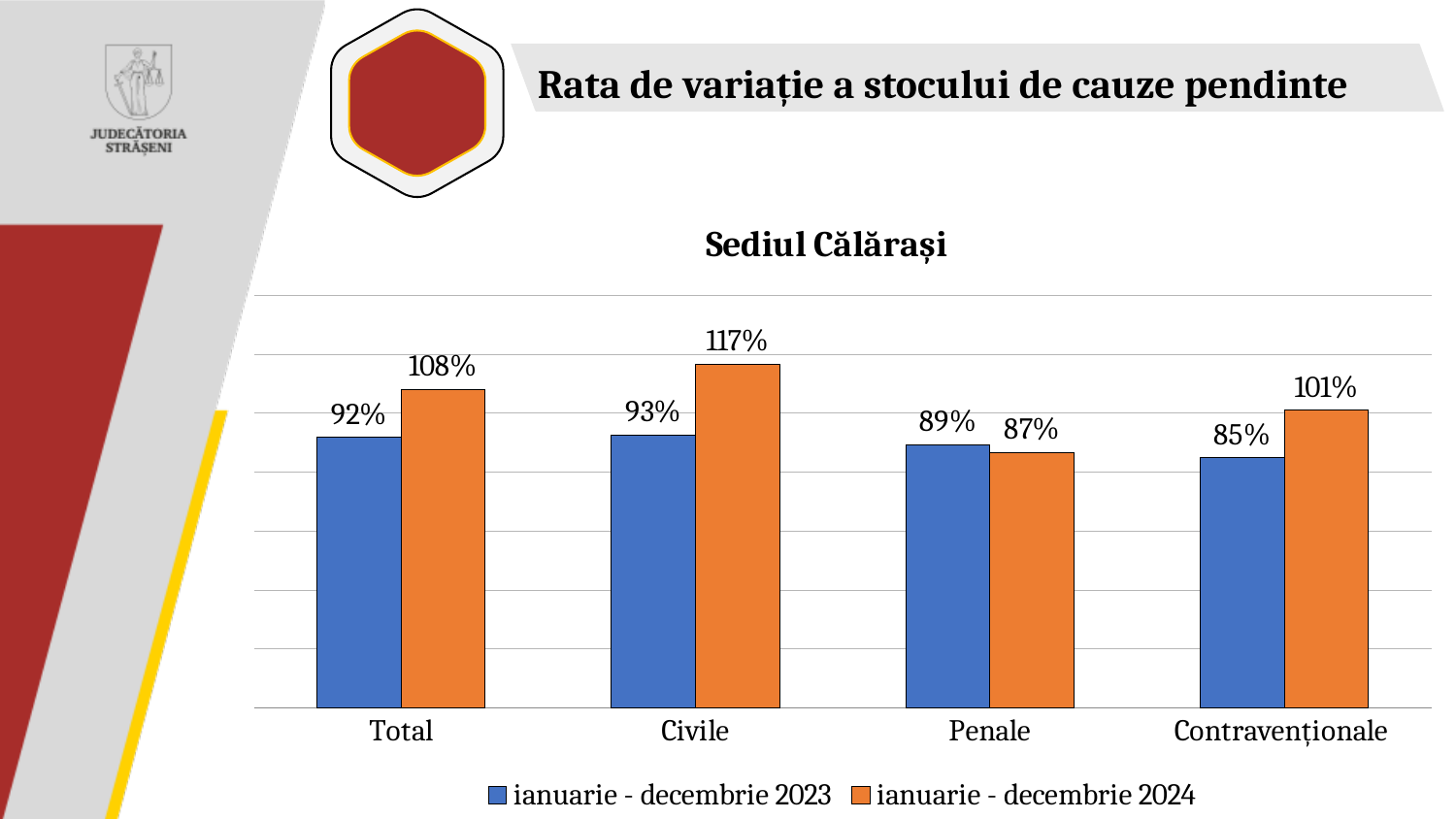
How many series does the legend list? 2 What is the title of the chart? Sediul Călărași What is the difference between the 2024 and 2023 values for Civile? 24% How many categories are shown on the x axis? 4 For Penale, which series has the larger value, ianuarie - decembrie 2023 or ianuarie - decembrie 2024? ianuarie - decembrie 2023 What is the value for Civile in the ianuarie - decembrie 2024 series? 117% Which category has the highest value in the ianuarie - decembrie 2024 series? Civile What is the difference between the 2024 and 2023 values for Total? 16% Which category has the lowest value in the ianuarie - decembrie 2023 series? Contravenționale What is the value for Contravenționale in the ianuarie - decembrie 2023 series? 85% What is the value for Penale in the ianuarie - decembrie 2024 series? 87% What kind of chart is shown on the slide? Bar chart